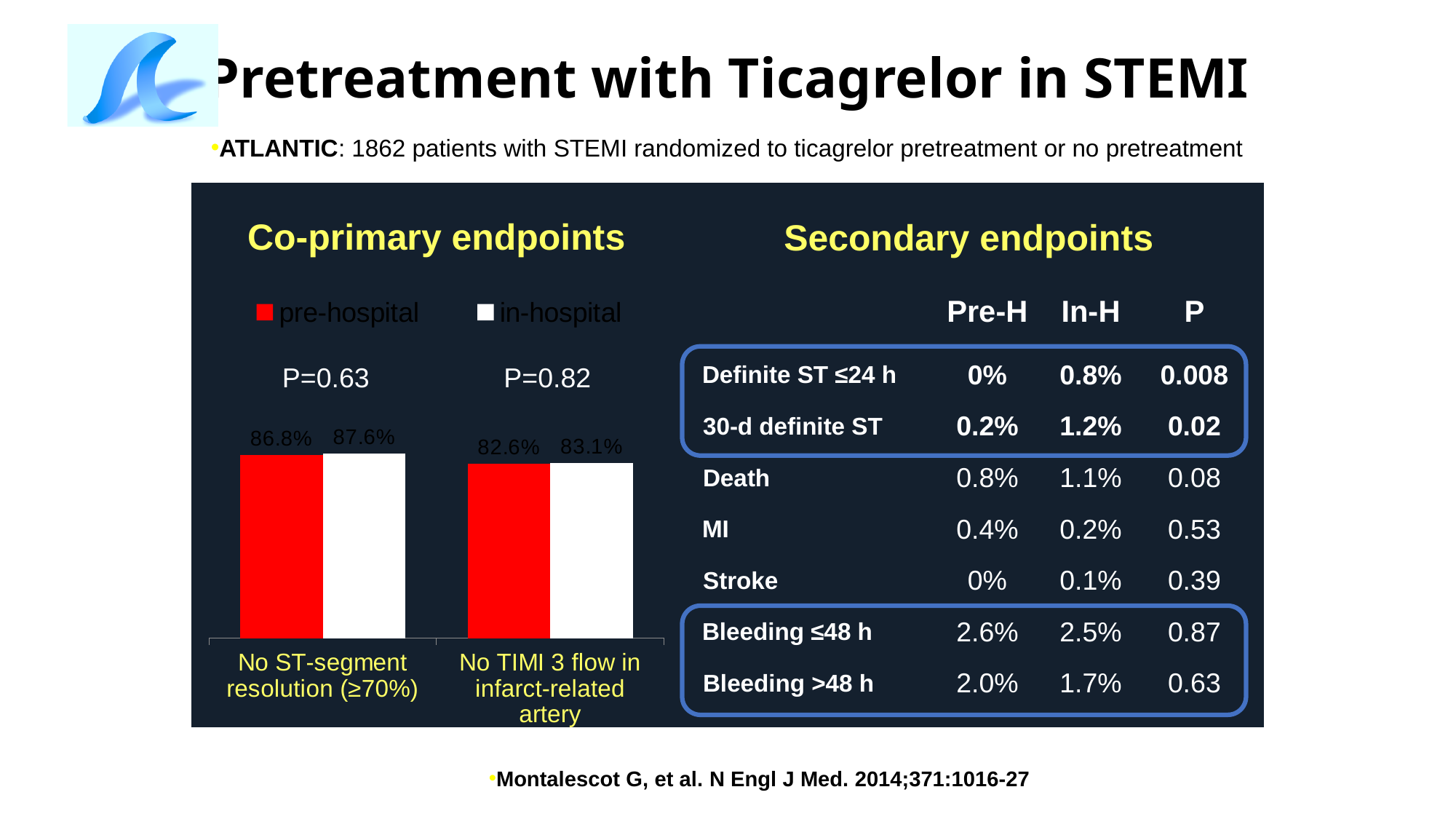
In the Co-primary endpoints chart, what is the pre-hospital value for No TIMI 3 flow in infarct-related artery? 82.6% In the Co-primary endpoints chart, which series is shown in red? pre-hospital In the Co-primary endpoints chart, what is the in-hospital value for No TIMI 3 flow in infarct-related artery? 83.1% In the Co-primary endpoints chart, what is the difference between the in-hospital and pre-hospital values for No TIMI 3 flow in infarct-related artery? 0.5% In the Co-primary endpoints chart, how many series does the legend list? 2 What kind of chart is shown under "Co-primary endpoints"? bar chart In the Co-primary endpoints chart, which category has the highest pre-hospital value? No ST-segment resolution (≥70%) In the Co-primary endpoints chart, what is the difference between the in-hospital and pre-hospital values for No ST-segment resolution (≥70%)? 0.8% In the Co-primary endpoints chart, how many categories are shown on the x axis? 2 In the Co-primary endpoints chart, what P value is shown above the No ST-segment resolution (≥70%) bars? P=0.63 In the Co-primary endpoints chart, what is the pre-hospital value for No ST-segment resolution (≥70%)? 86.8% In the Co-primary endpoints chart, what is the in-hospital value for No ST-segment resolution (≥70%)? 87.6%